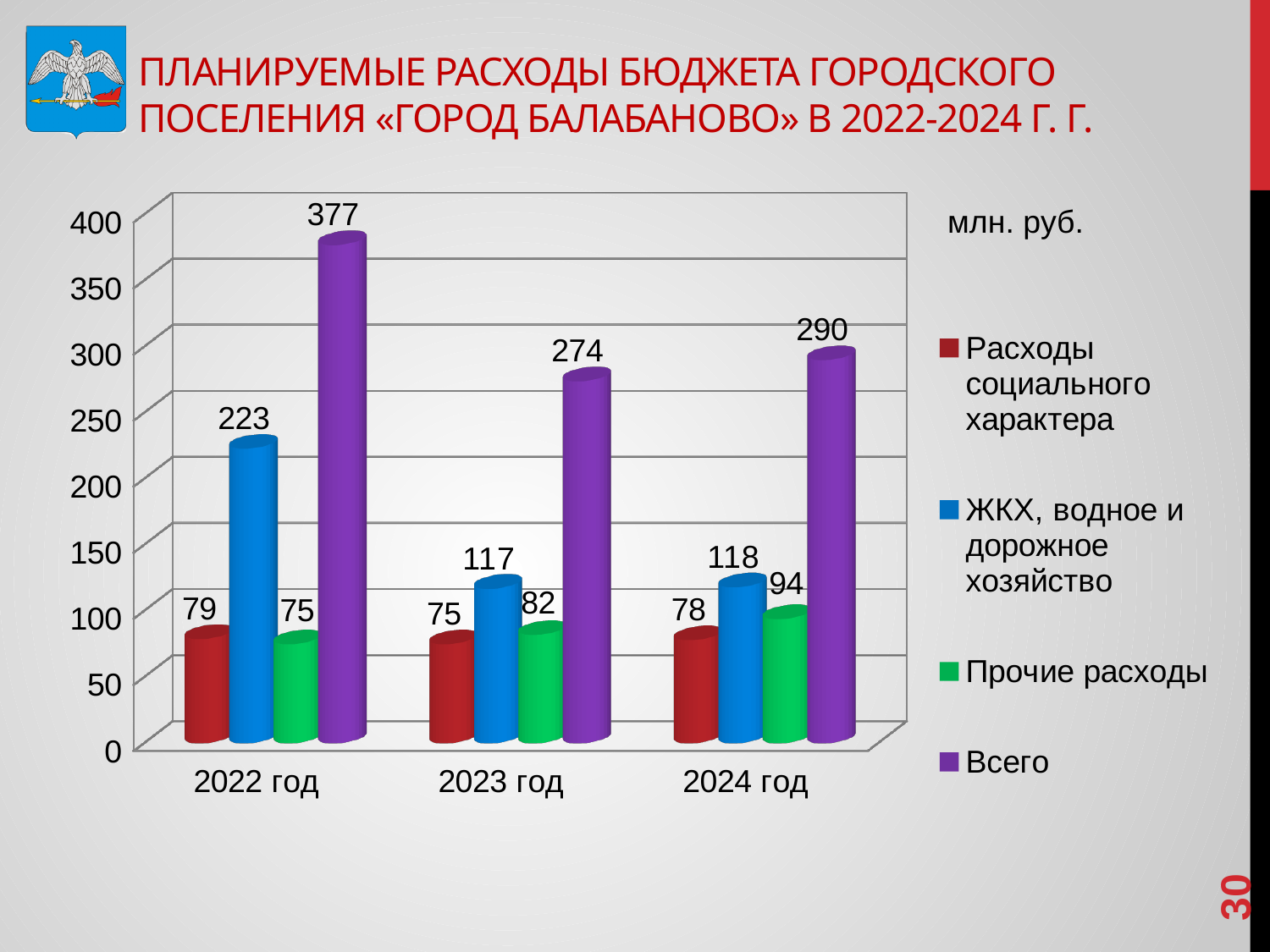
In which year is the «ЖКХ, водное и дорожное хозяйство» value the highest? 2022 год In which year is the «Всего» value the lowest? 2023 год What is the difference between the «Всего» values for 2022 год and 2024 год? 87 What is the value for «Прочие расходы» in 2024 год? 94 Which is larger: «Прочие расходы» in 2023 год or «Расходы социального характера» in 2023 год? Прочие расходы in 2023 год What is the value for «Всего» in 2022 год? 377 How many series does the legend list? 4 What kind of chart is shown on the slide? Bar chart How many year categories are shown on the x axis? 3 What is the value for «ЖКХ, водное и дорожное хозяйство» in 2023 год? 117 What is the value for «Расходы социального характера» in 2023 год? 75 What unit is indicated next to the chart? млн. руб.